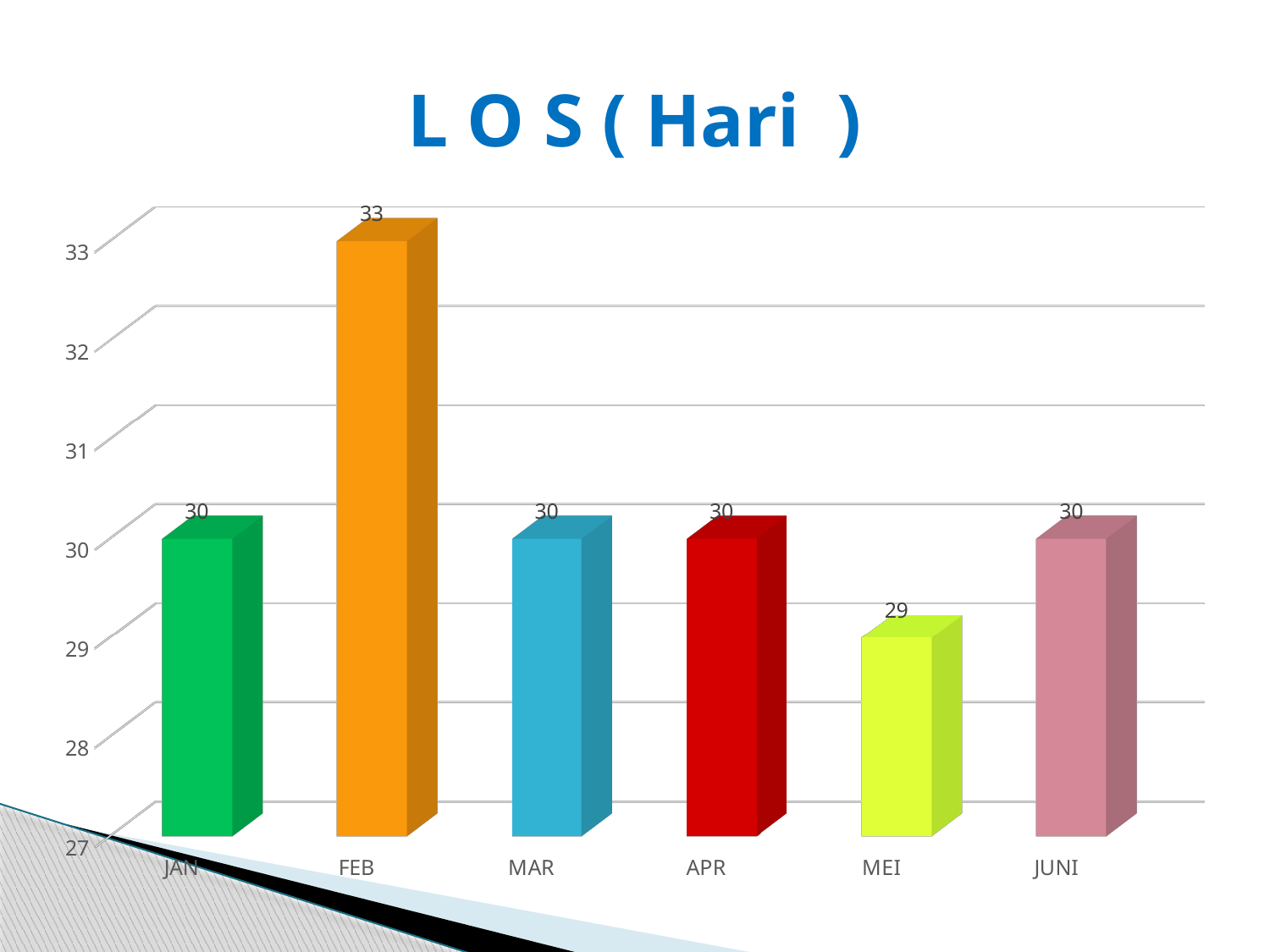
What is the title of the chart? L O S ( Hari ) Which month has the lowest value? MEI Which month has the highest value? FEB What is the value for FEB? 33 Is the value for FEB greater or less than 32? greater What is the value for MEI? 29 What is the difference between the values for FEB and MEI? 4 What kind of chart is shown? bar chart Which is larger, the value for FEB or the value for APR? FEB How many months are shown on the x axis? 6 What is the value for JAN? 30 What colour is the bar for FEB? orange